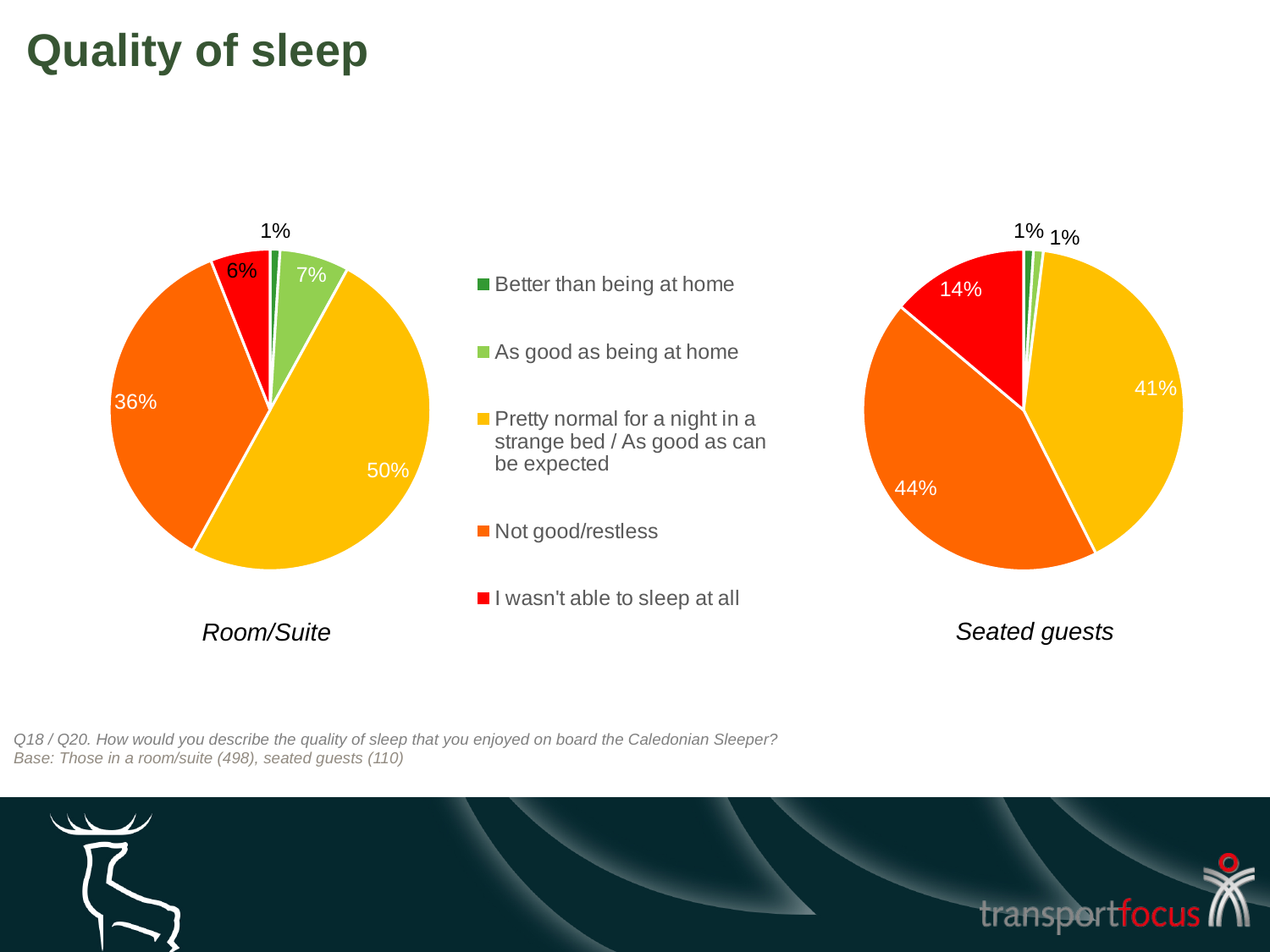
Which group has a larger share saying they weren't able to sleep at all, Room/Suite or Seated guests? Seated guests How many categories does the legend list? 5 In the Seated guests chart, what share of respondents said they weren't able to sleep at all? 14% In the Room/Suite chart, what is the difference between the Not good/restless share and the I wasn't able to sleep at all share? 30 percentage points In the Room/Suite chart, which category has the largest slice? Pretty normal for a night in a strange bed / As good as can be expected What type of chart is used on this slide? Pie chart In the Seated guests chart, what share of respondents said their sleep was not good/restless? 44% What is the difference between the Not good/restless share for Seated guests and for Room/Suite? 8 percentage points In the Room/Suite chart, what share of respondents said their sleep was pretty normal for a night in a strange bed / as good as can be expected? 50% Which colour represents the Not good/restless category in the legend? Orange In the Room/Suite chart, what share of respondents said their sleep was as good as being at home? 7% In the Seated guests chart, which category has the largest slice? Not good/restless